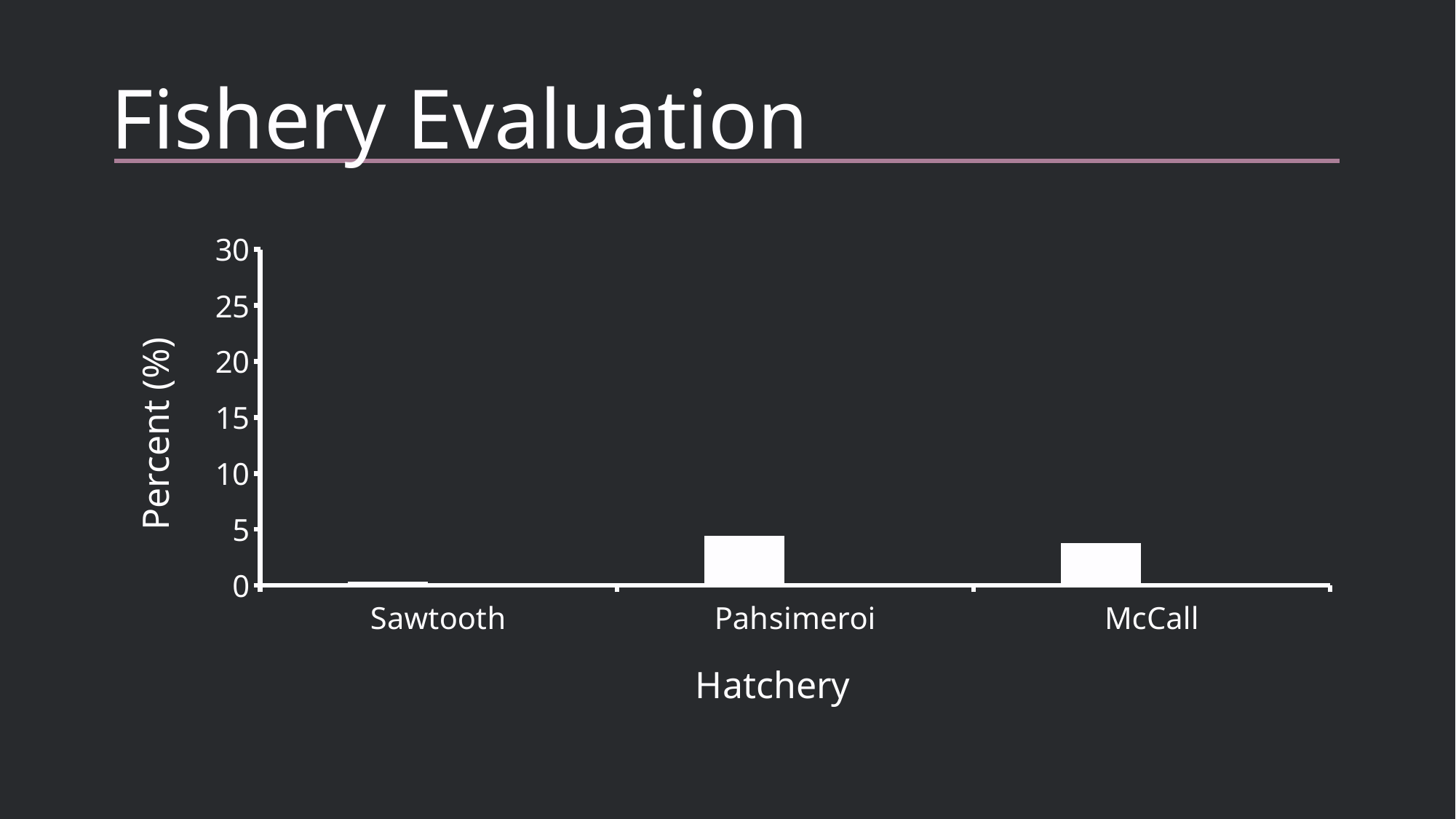
What is the label of the x axis of the chart? Hatchery Which hatchery has a larger percent value, Pahsimeroi or McCall? Pahsimeroi What is the label of the y axis of the chart? Percent (%) Which hatchery has a larger percent value, Sawtooth or McCall? McCall Which hatchery has the highest percent value in the chart? Pahsimeroi Which hatchery has the lowest percent value in the chart? Sawtooth What kind of chart is shown on the slide? bar chart Is the value for McCall greater or less than 10? less Is the value for Sawtooth greater or less than 5? less How many hatcheries are shown on the x axis of the chart? 3 Is the value for Pahsimeroi greater or less than 5? less